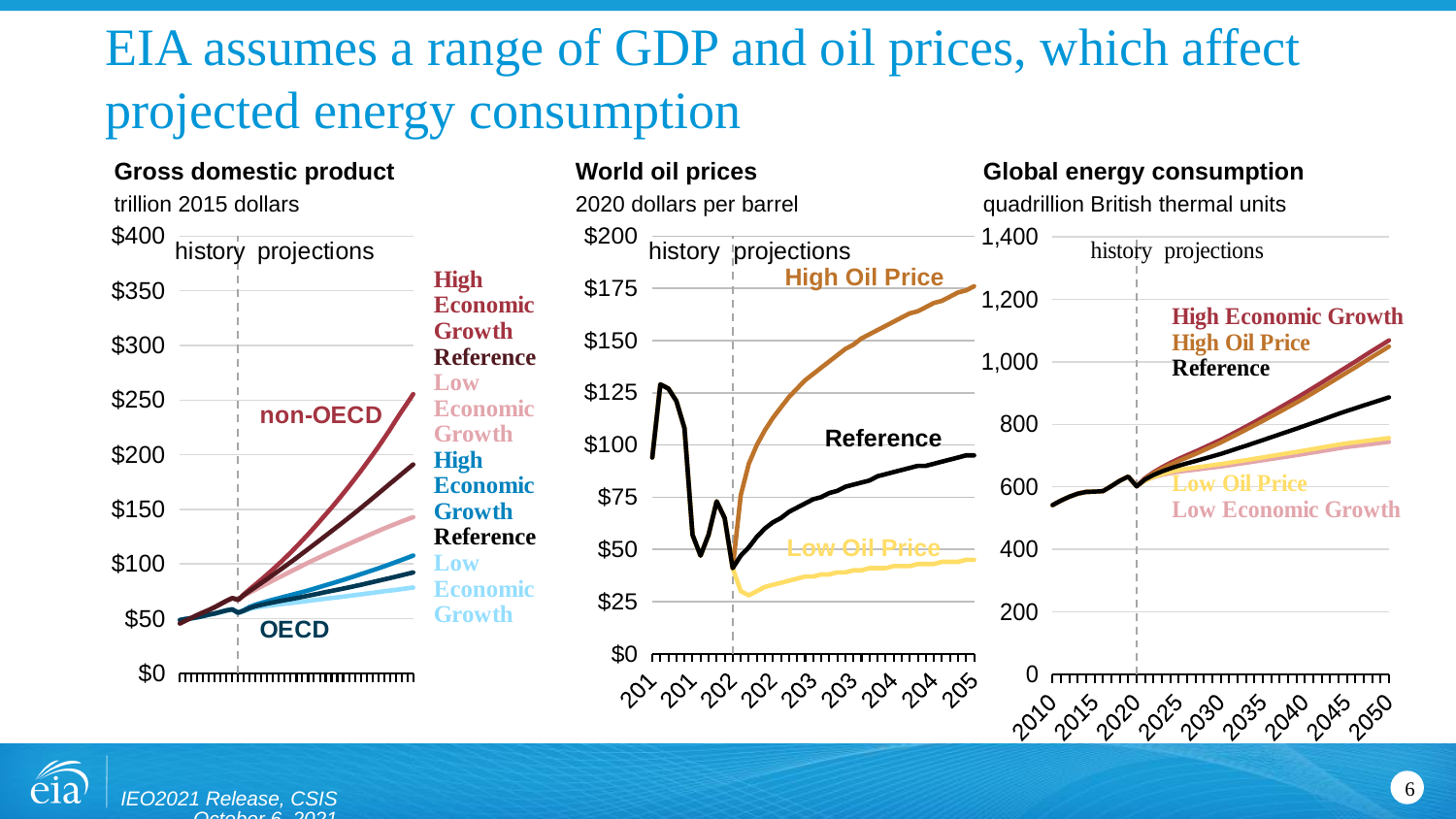
How many lines are plotted in the 'World oil prices' chart? 3 In the 'World oil prices' chart, is the High Oil Price value in 2050 greater or less than $150? greater In the 'World oil prices' chart, is the Low Oil Price value in 2050 greater or less than $50? less In the 'Global energy consumption' chart, is the High Economic Growth value in 2050 greater or less than 1,000? greater In the 'Global energy consumption' chart, which is higher in 2050, High Economic Growth or Low Economic Growth? High Economic Growth What kind of chart is the 'World oil prices' chart? line chart In the 'Global energy consumption' chart, does the Reference line rise or fall over the projection period? rise What unit is used on the 'Global energy consumption' chart? quadrillion British thermal units In the 'World oil prices' chart, which is higher in 2050, the High Oil Price line or the Reference line? High Oil Price